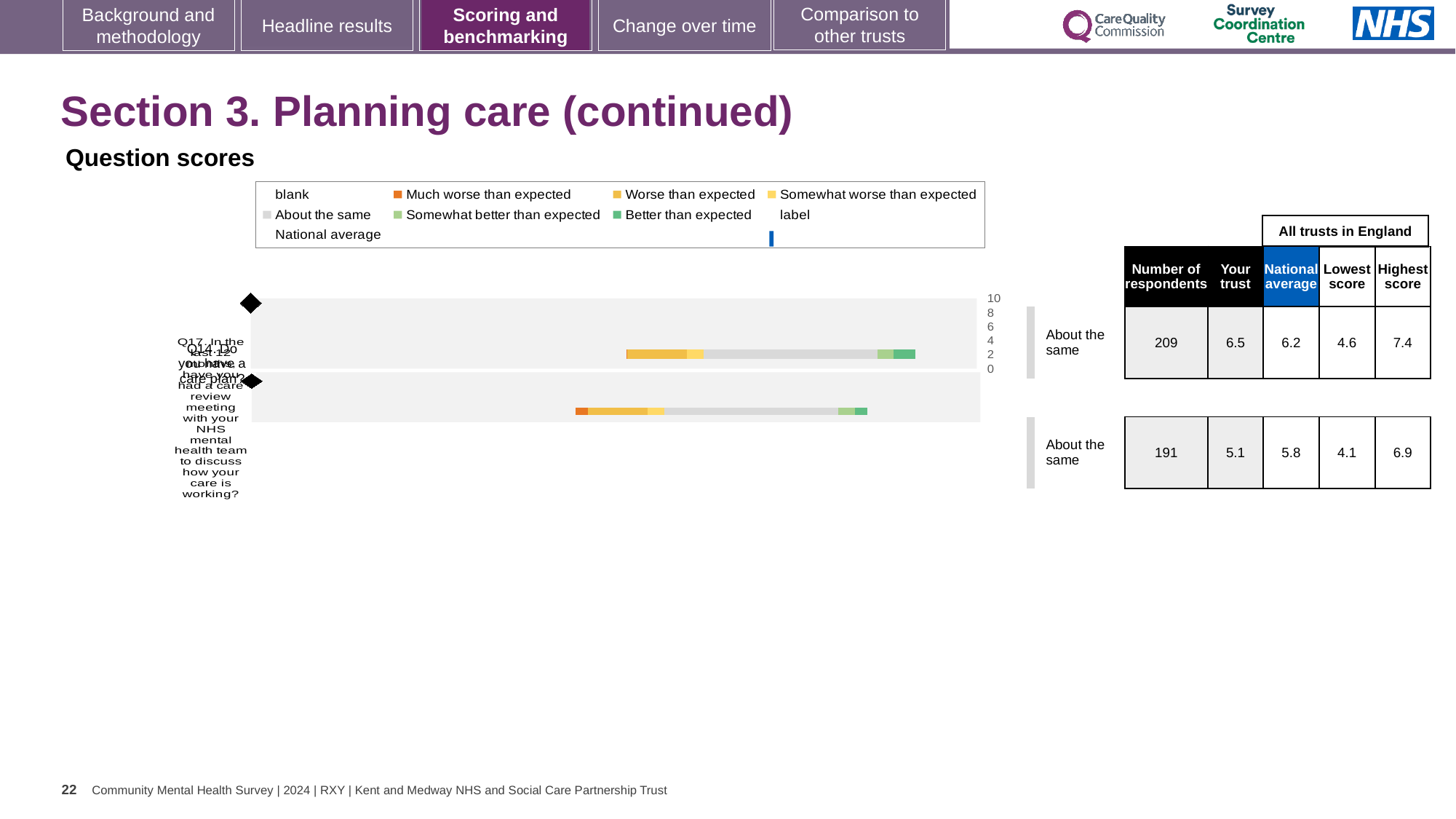
What colour does the legend use for "Better than expected"? green What kind of chart is shown under "Question scores"? bar chart What colour does the legend use for "Much worse than expected"? orange For the top row (Q14), which is larger: the "Your trust" score or the "National average"? Your trust In the table, what is the "Your trust" score for the top row (Q14)? 6.5 In the table, how many respondents are listed for the bottom row (Q17)? 191 In the table, what is the "National average" for the bottom row (Q17)? 5.8 What is the difference between the highest score and the lowest score for the bottom row (Q17)? 2.8 What is the difference between the "Your trust" score and the "National average" for the top row (Q14)? 0.3 In the table, what is the highest score across all trusts in England for the top row (Q14)? 7.4 For the bottom row (Q17), which is larger: the "Your trust" score or the "National average"? National average How many question bars are plotted in the chart? 2